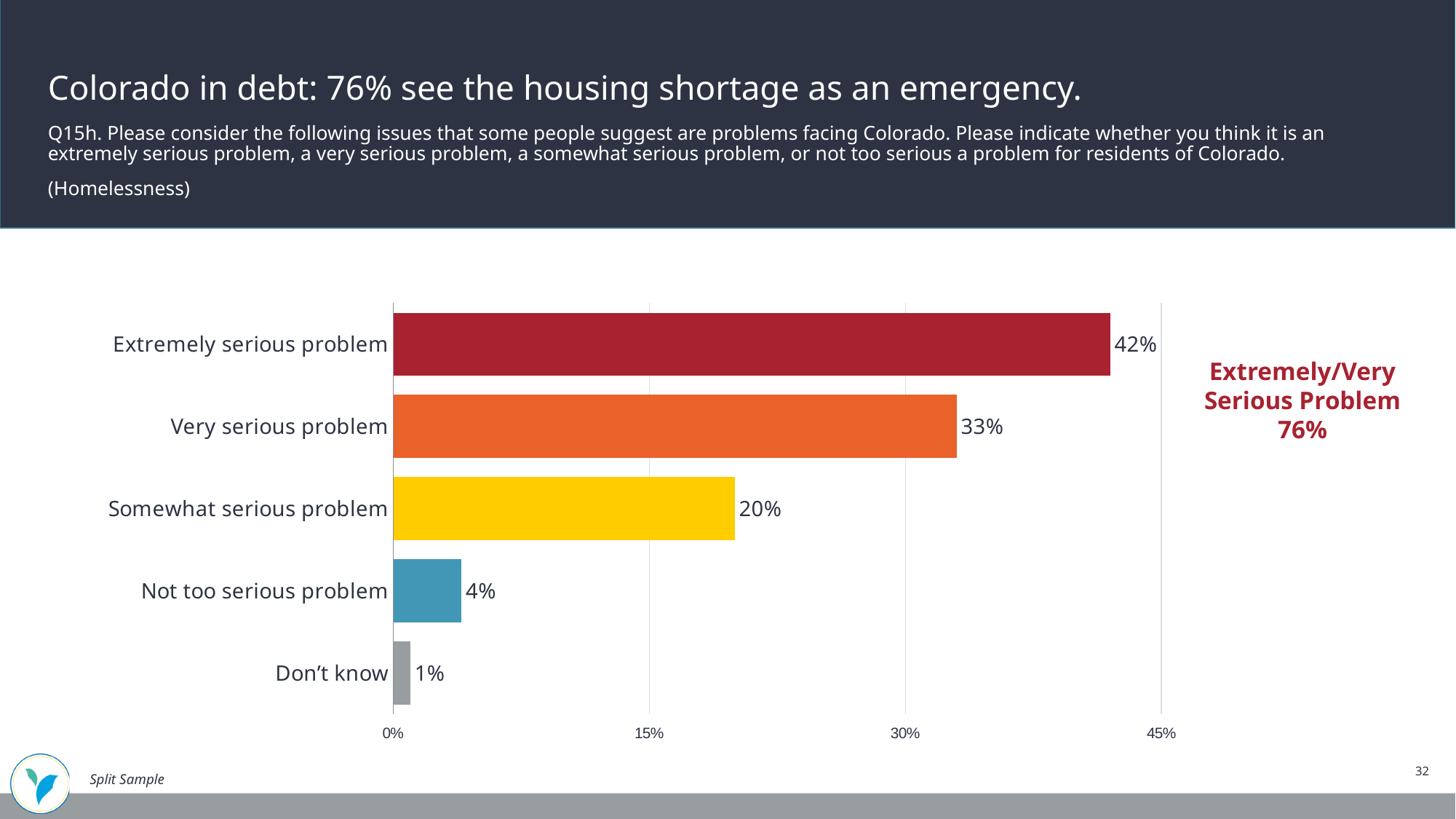
What is the difference between 'Extremely serious problem' and 'Very serious problem'? 9 percentage points What percentage of respondents said homelessness is an extremely serious problem? 42% Is the value for 'Very serious problem' greater or less than 30%? greater Which is larger, 'Somewhat serious problem' or 'Not too serious problem'? Somewhat serious problem Which category has the lowest value? Don't know What combined percentage is shown for 'Extremely/Very Serious Problem' next to the chart? 76% What kind of chart is shown on the slide? Bar chart How many categories are shown in the chart? 5 What is the value for 'Somewhat serious problem'? 20% What is the value for 'Don't know'? 1% What is the value for 'Very serious problem'? 33% Which category has the highest value? Extremely serious problem